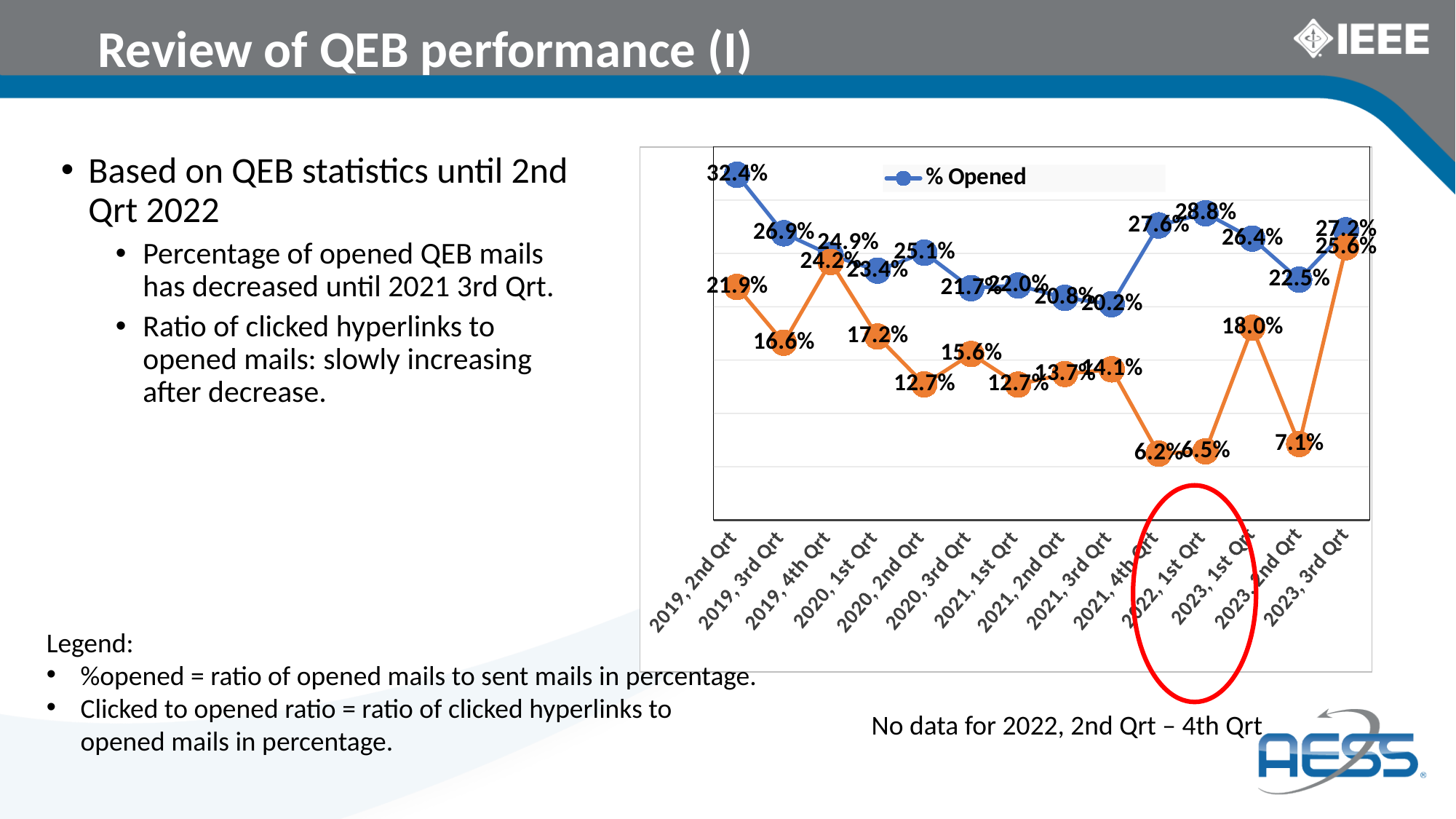
What is the value of the orange line for 2023, 3rd Qrt? 25.6% What type of chart is shown on the slide? Line chart What series name is shown in the chart's legend? % Opened How many quarters (categories) are plotted along the x axis of the chart? 14 Which quarter has the highest % Opened value? 2019, 2nd Qrt Does the % Opened line generally rise or fall from 2019, 2nd Qrt to 2021, 3rd Qrt? Fall Which has the higher % Opened value: 2020, 1st Qrt or 2020, 2nd Qrt? 2020, 2nd Qrt What is the value of the orange line for 2023, 1st Qrt? 18.0% What is the % Opened value for 2019, 2nd Qrt? 32.4% Which quarter has the lowest value on the orange line? 2021, 4th Qrt Which quarter has the lowest % Opened value? 2021, 3rd Qrt By how many percentage points does % Opened for 2022, 1st Qrt exceed % Opened for 2021, 4th Qrt? 1.2